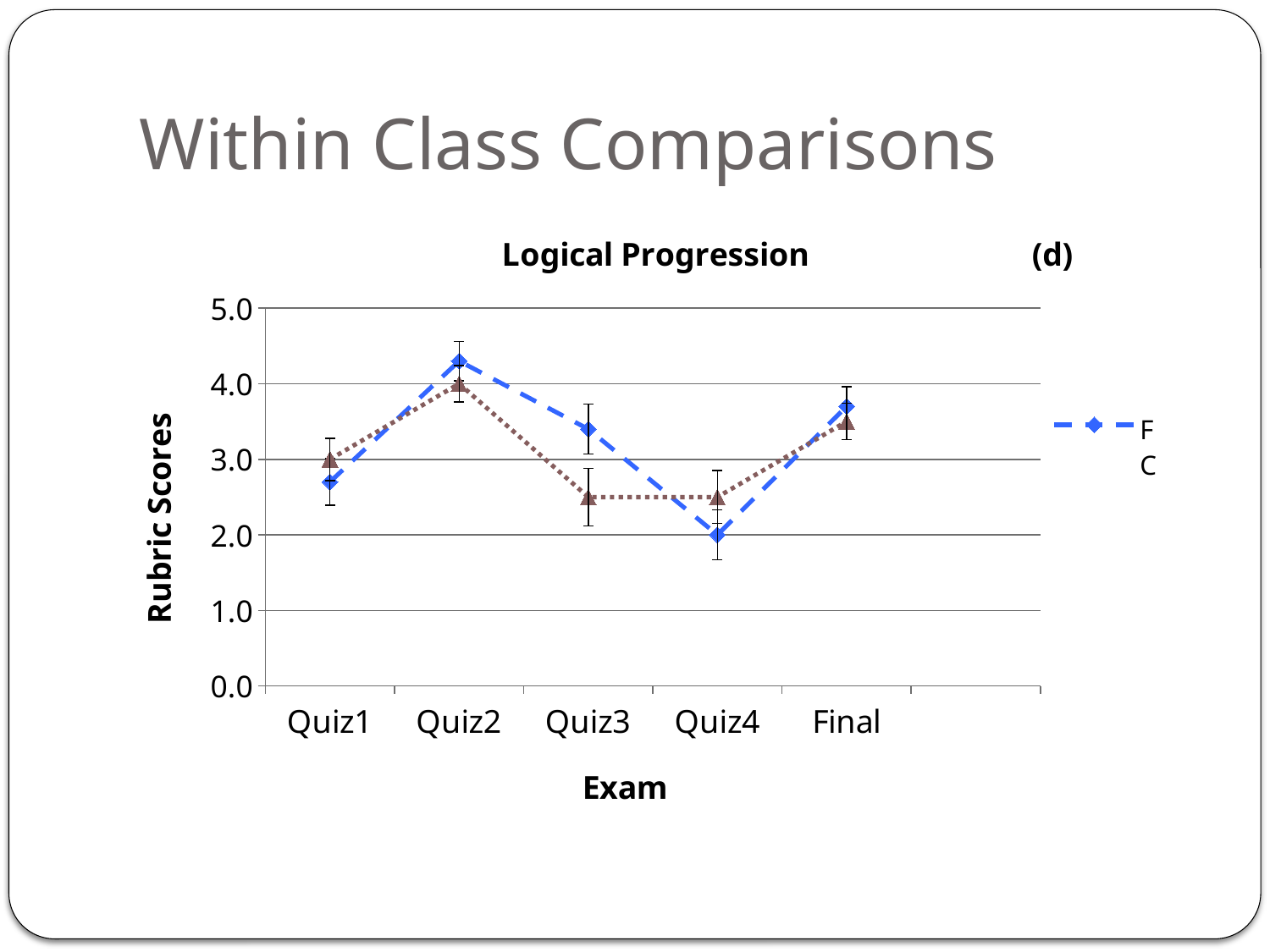
What is the title of the chart? Logical Progression What kind of chart is shown on the slide? line chart At Quiz4, which series has the higher rubric score, F or C? C Does the value for series F rise or fall from Quiz3 to Quiz4? fall Is the value for series C at Quiz3 greater or less than 3.0? less For series F, which exam has the lowest rubric score? Quiz4 At Quiz3, which series has the higher rubric score, F or C? F For series F, which exam has the highest rubric score? Quiz2 How many exams are shown along the x axis of the chart? 5 How many series does the chart's legend list? 2 For series C, which exam has the highest rubric score? Quiz2 Is the value for series F at Quiz2 greater or less than 4.0? greater